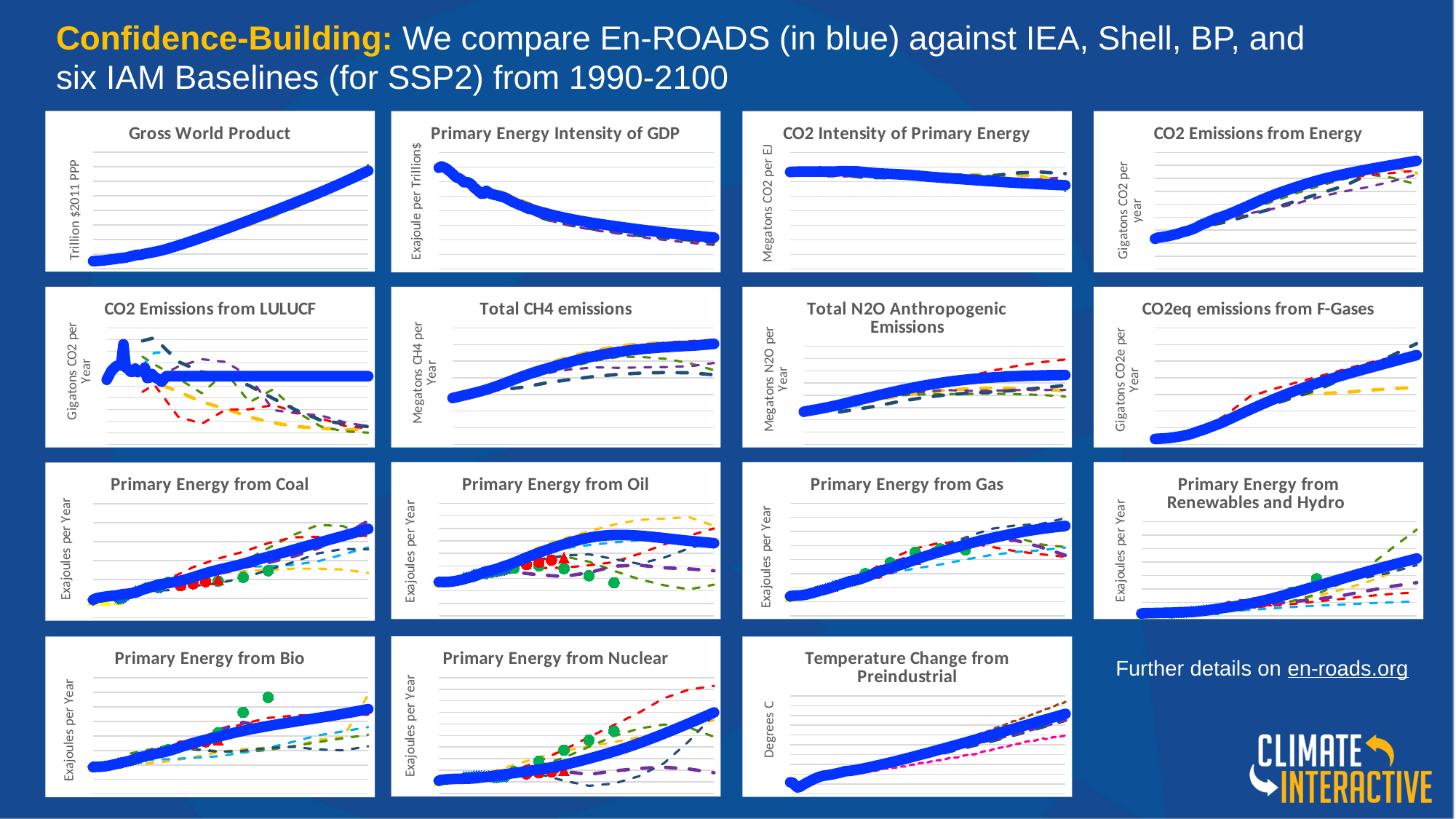
How many charts are shown on the slide? 15 In the "CO2eq emissions from F-Gases" chart, does the blue En-ROADS line rise or fall over time? rise In the "Temperature Change from Preindustrial" chart, does the blue En-ROADS line rise or fall over time? rise In the "CO2 Emissions from Energy" chart, does the blue En-ROADS line rise or fall over time? rise What kind of chart is the "Primary Energy from Nuclear" chart? line chart What is the y-axis label of the "Primary Energy from Coal" chart? Exajoules per Year What is the y-axis label of the "Temperature Change from Preindustrial" chart? Degrees C What kind of chart is the "Gross World Product" chart? line chart